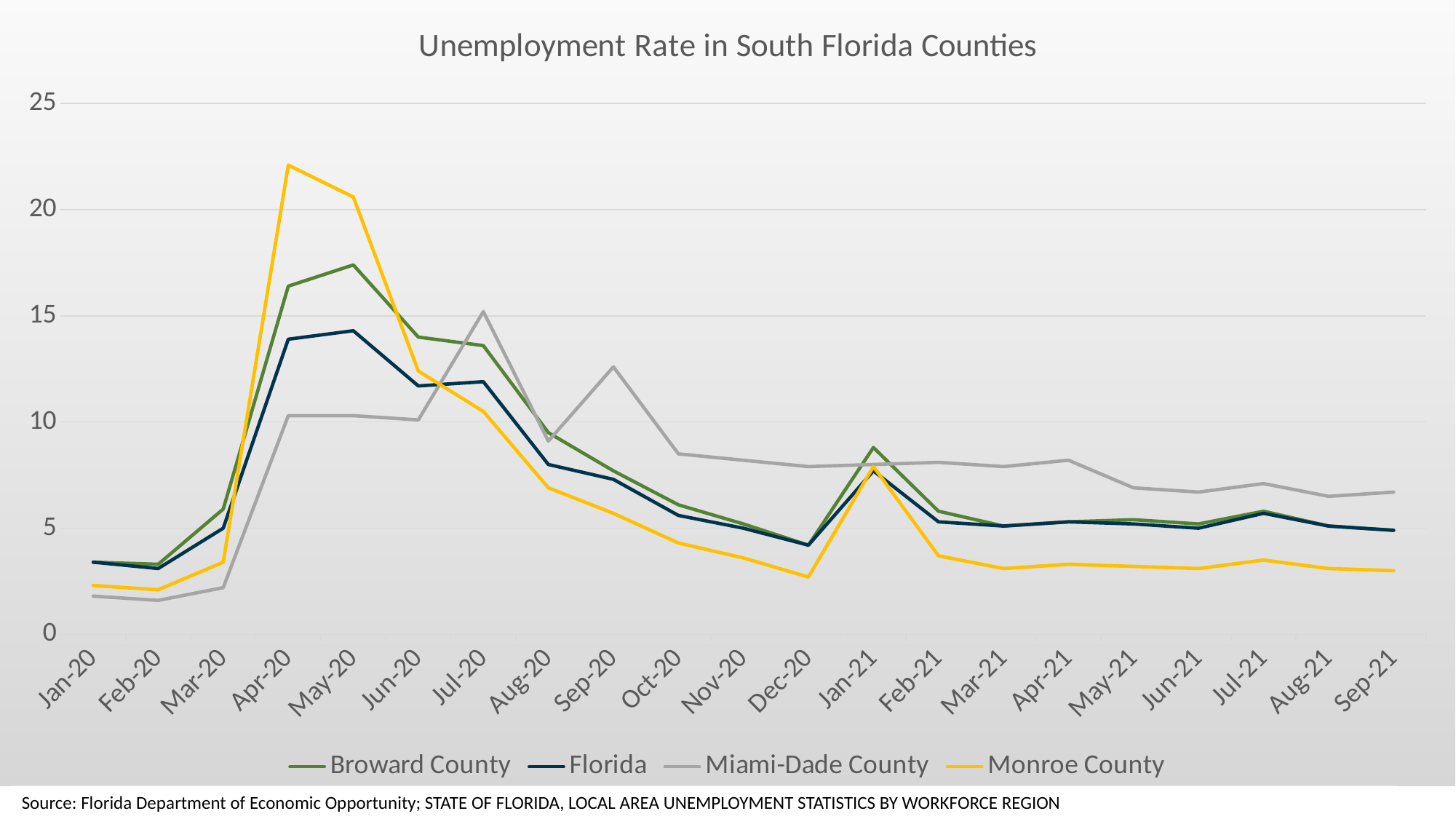
Is the value for Monroe County in Sep-21 greater or less than 5? less How many months are plotted along the x axis? 21 Which series reaches the highest unemployment rate on the chart? Monroe County What kind of chart is shown on the slide? line chart Which series is drawn in yellow? Monroe County Is the value for Monroe County in Apr-20 greater or less than 20? greater How many series does the legend list? 4 Is the value for Miami-Dade County in Apr-20 greater or less than 15? less In which month does Monroe County reach its peak? Apr-20 Which series has the lowest value in Sep-21? Monroe County In Sep-20, which is higher, Miami-Dade County or Florida? Miami-Dade County